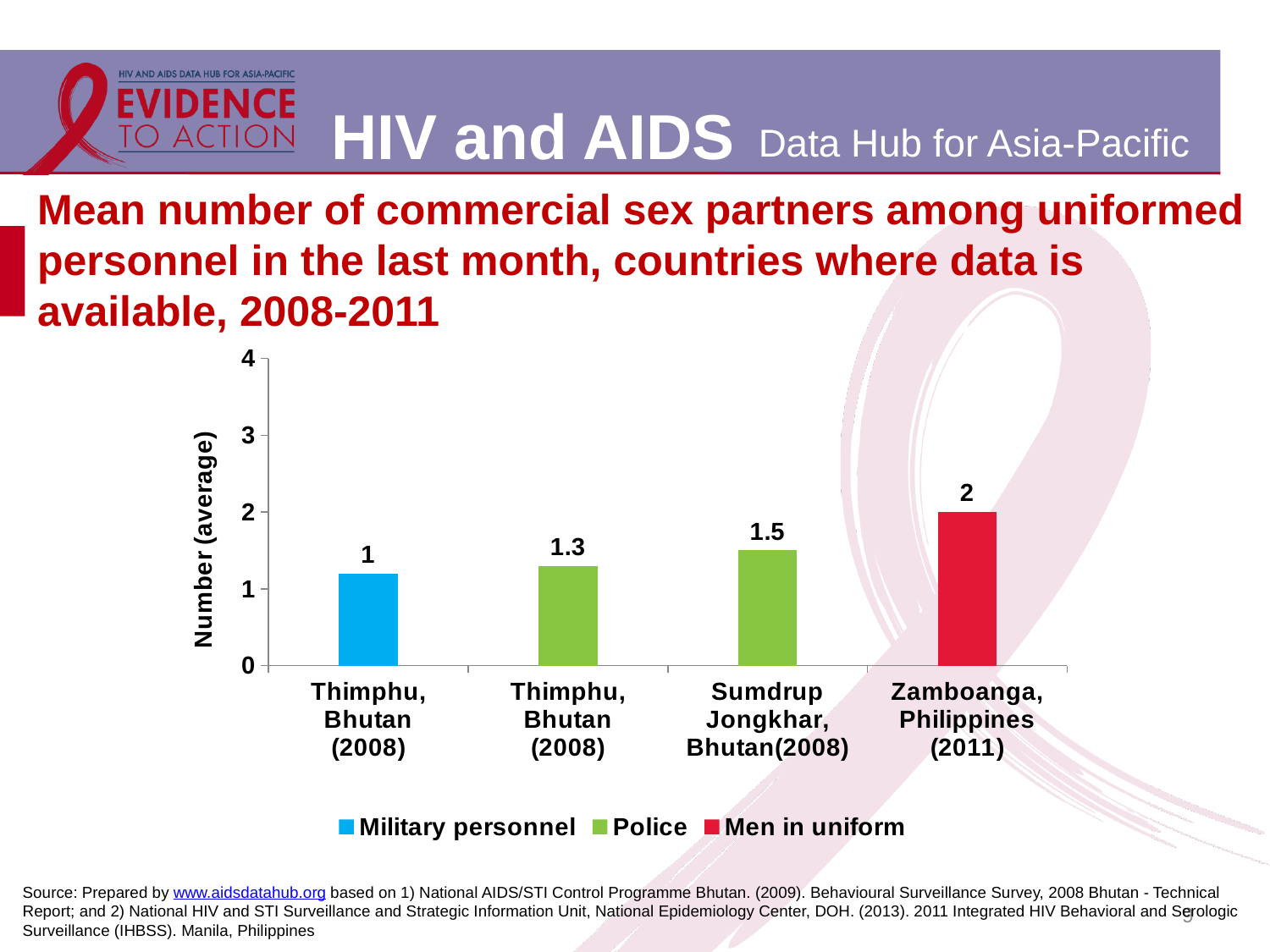
What is the difference between the values for Zamboanga, Philippines (2011) and Sumdrup Jongkhar, Bhutan (2008)? 0.5 How many series does the legend list? 3 What is the mean number of commercial sex partners for Zamboanga, Philippines (2011)? 2 What is the value for Sumdrup Jongkhar, Bhutan (2008)? 1.5 Which category has the highest mean number of commercial sex partners? Zamboanga, Philippines (2011) Which is larger: the value for Sumdrup Jongkhar, Bhutan (2008) or the Police value for Thimphu, Bhutan (2008)? Sumdrup Jongkhar, Bhutan (2008) What kind of chart is shown on the slide? Bar chart How many bars are shown on the chart? 4 What is the value for Police in Thimphu, Bhutan (2008)? 1.3 What is the value for Military personnel in Thimphu, Bhutan (2008)? 1 Is the value for Zamboanga, Philippines (2011) greater or less than 3? less Which series has the lowest value on the chart? Military personnel